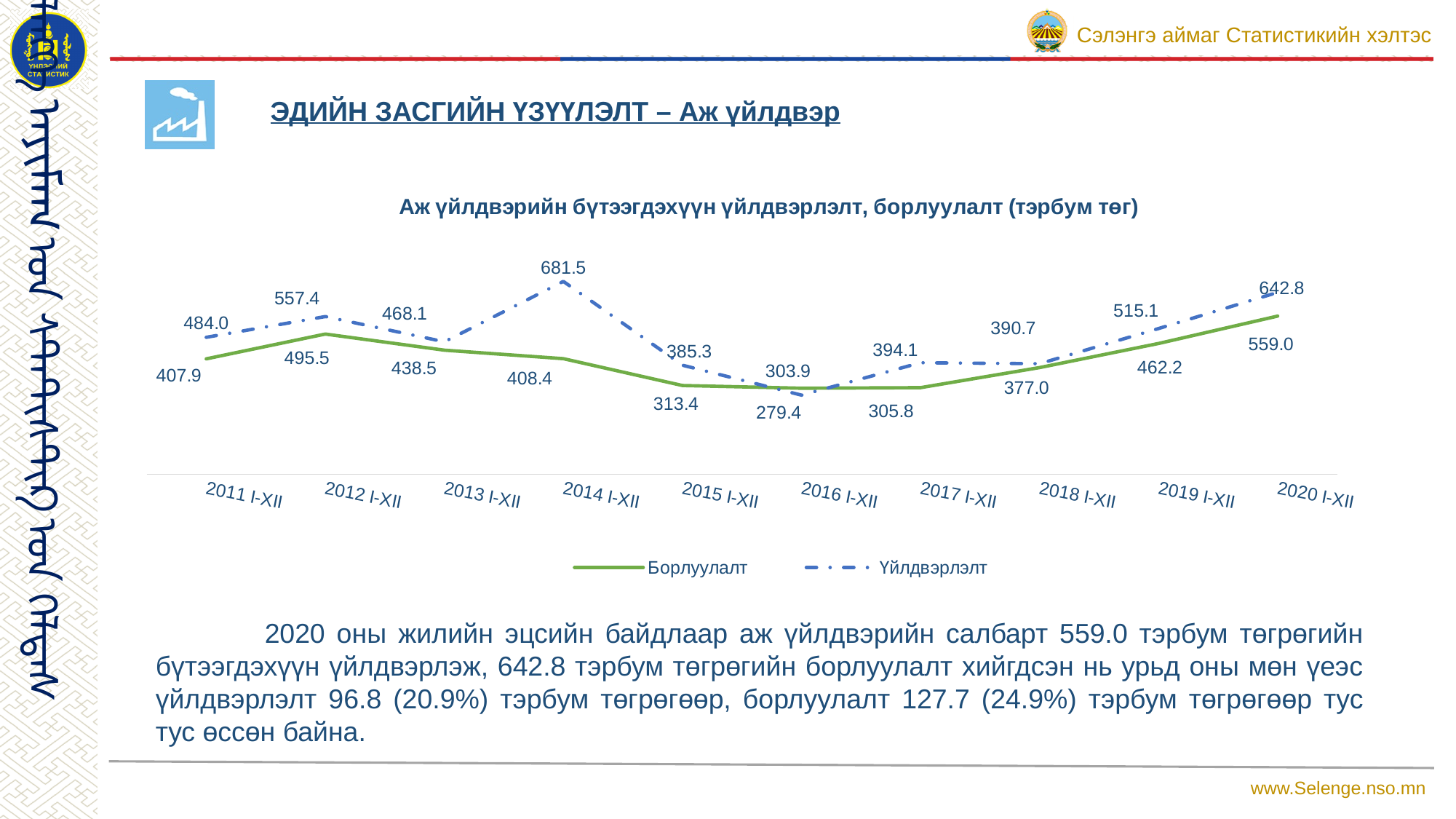
In which period is Борлуулалт highest? 2020 I-XII In which period is Үйлдвэрлэлт highest? 2014 I-XII What is the Борлуулалт value for 2020 I-XII? 559.0 What type of chart is shown on the slide? Line chart What is the Үйлдвэрлэлт value for 2014 I-XII? 681.5 What is the difference between Үйлдвэрлэлт and Борлуулалт in 2020 I-XII? 83.8 How many periods are plotted along the x axis? 10 By how much did Үйлдвэрлэлт increase from 2019 I-XII to 2020 I-XII? 127.7 Does Борлуулалт rise or fall from 2017 I-XII to 2020 I-XII? Rise In 2012 I-XII, which is larger: Үйлдвэрлэлт or Борлуулалт? Үйлдвэрлэлт How many series does the legend list? 2 What is the Борлуулалт value for 2011 I-XII? 407.9